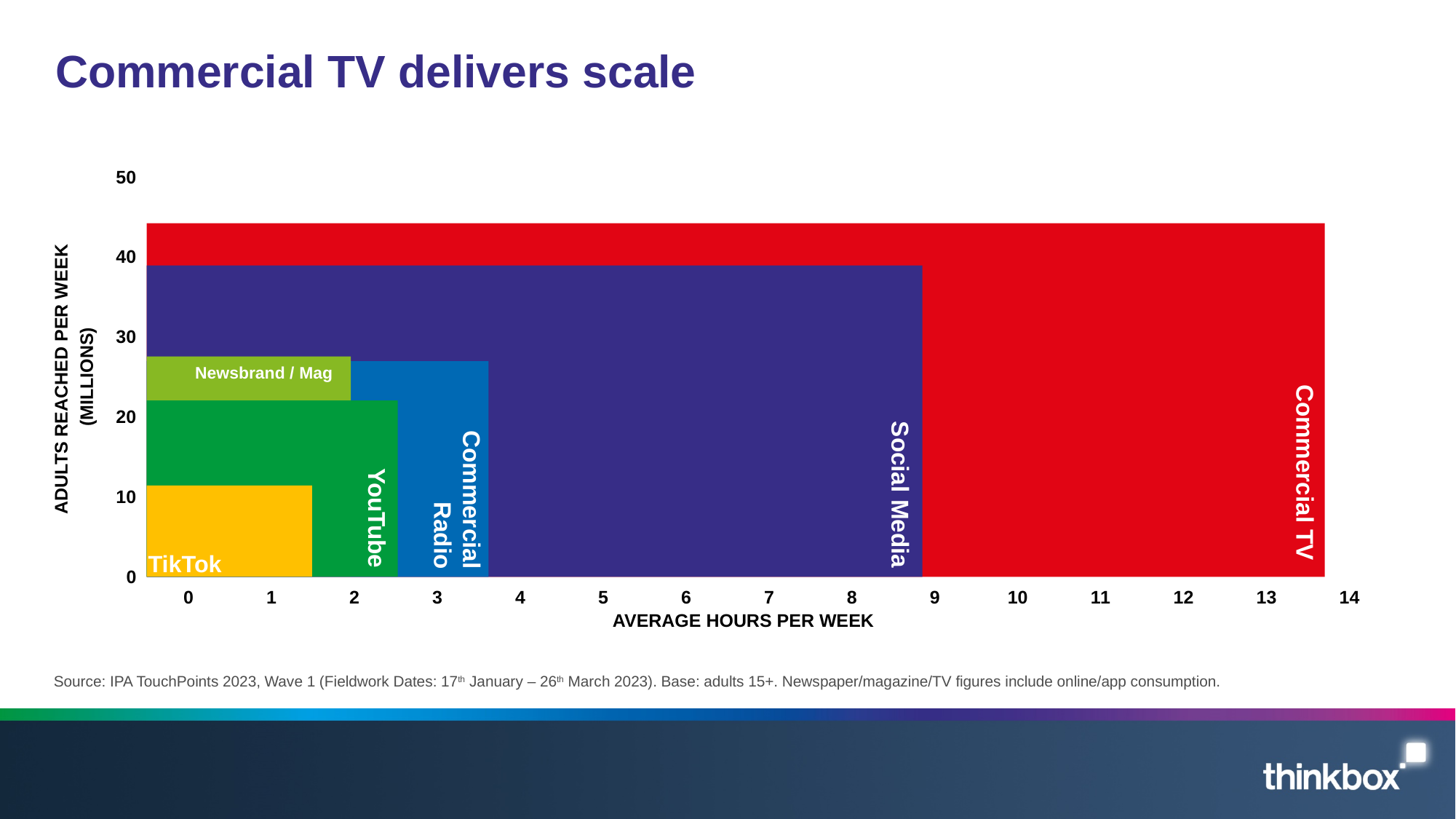
Is the number of adults reached per week by Commercial TV greater or less than 40 million? greater How many media are shown on the chart? 6 Is the average hours per week for Commercial TV greater or less than 12? greater Which medium reaches the most adults per week? Commercial TV Which medium has the highest average hours per week? Commercial TV Which has more average hours per week, Social Media or Commercial Radio? Social Media Which medium reaches the fewest adults per week? TikTok Is the number of adults reached per week by TikTok greater or less than 20 million? less Which medium has the lowest average hours per week? TikTok What does the horizontal axis of the chart measure? Average hours per week